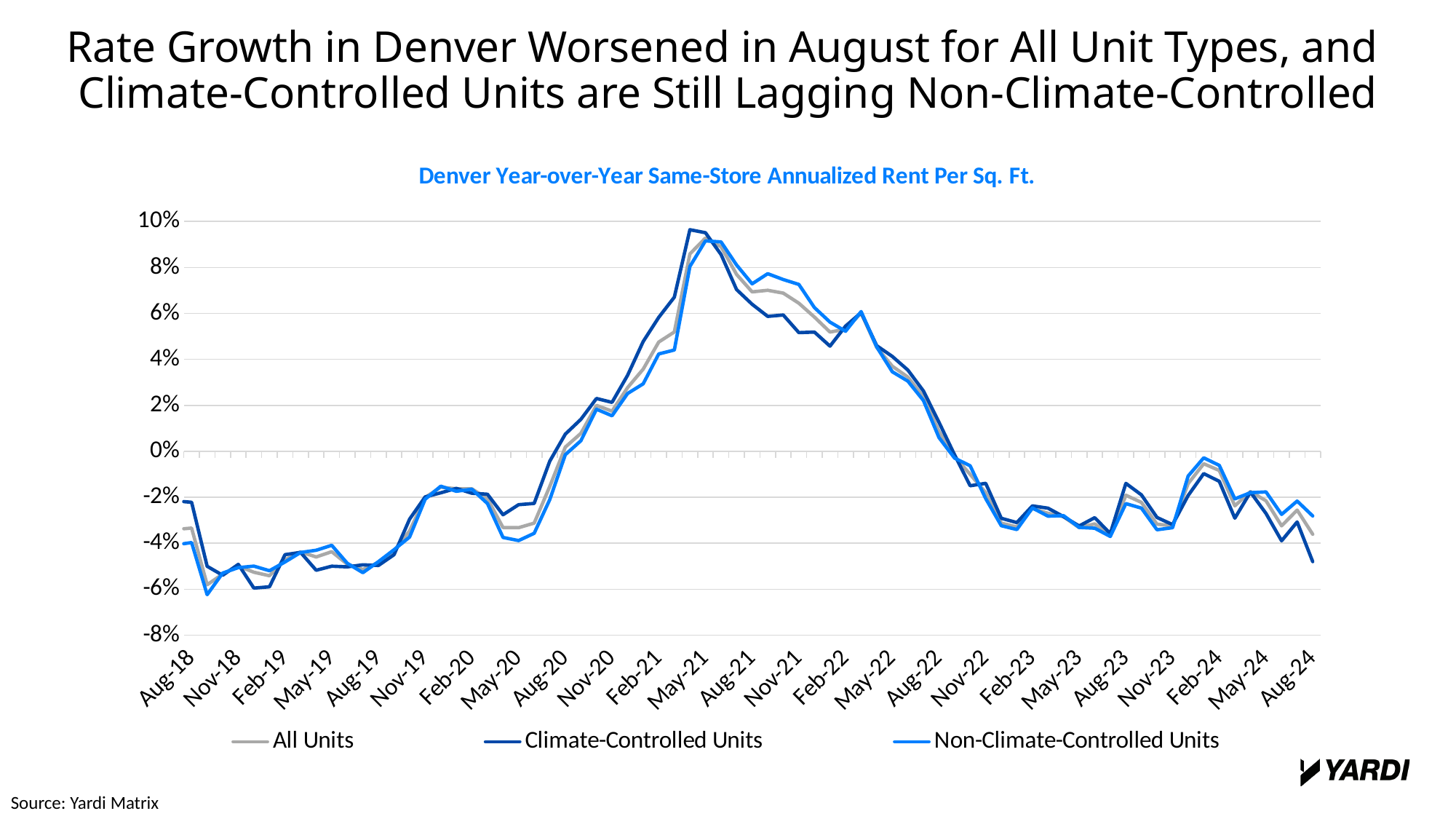
How many series does the legend list? 3 What kind of chart is shown on the slide? Line chart Is the value for Climate-Controlled Units at Aug-24 greater or less than -4%? less At Aug-21, which series is higher: Climate-Controlled Units or Non-Climate-Controlled Units? Non-Climate-Controlled Units What is the title of the chart? Denver Year-over-Year Same-Store Annualized Rent Per Sq. Ft. Which series is drawn in the dark blue line? Climate-Controlled Units Do the values for All Units rise or fall between Aug-20 and May-21? rise Is the value for Non-Climate-Controlled Units at Aug-24 greater or less than -4%? greater At Aug-24, which series is higher: Climate-Controlled Units or Non-Climate-Controlled Units? Non-Climate-Controlled Units Do the values for All Units rise or fall between May-21 and Nov-22? fall Is the peak value for Climate-Controlled Units around May-21 greater or less than 8%? greater How many date labels are shown on the x axis? 25